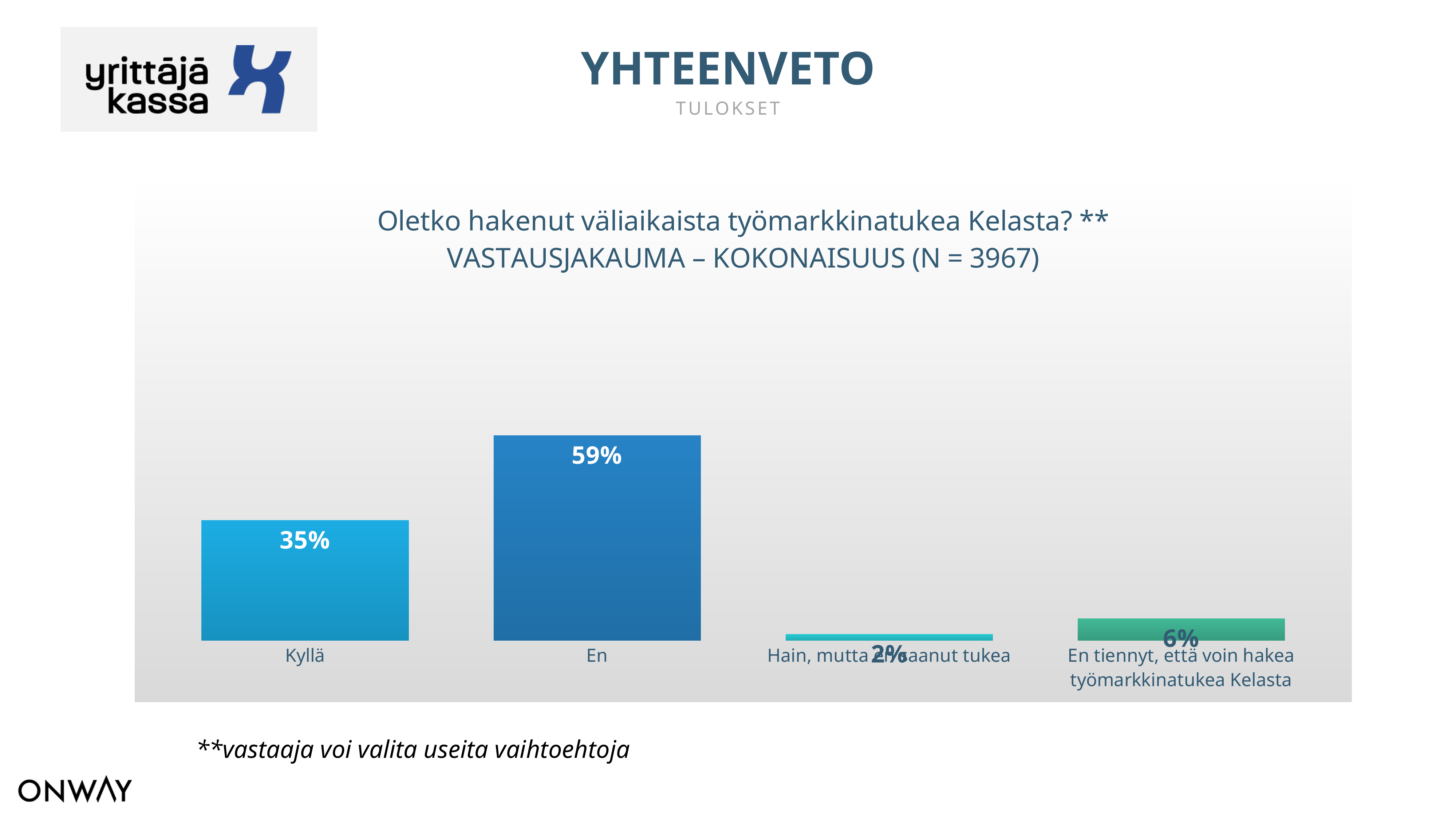
What percentage of respondents answered "En"? 59% Which category has the lowest value? Hain, mutta en saanut tukea What is the value shown for the third bar from the left ("Hain, mutta ... tukea")? 2% What is the difference between the values for "En" and "Kyllä"? 24% What kind of chart is shown on the slide? Bar chart What is the difference between the values for "En tiennyt, että voin hakea työmarkkinatukea Kelasta" and "Kyllä"? 29% What percentage of respondents answered "Kyllä"? 35% Which is larger, the value for "Kyllä" or the value for "En"? En What is the value shown for the category "En tiennyt, että voin hakea työmarkkinatukea Kelasta"? 6% Which category has the highest value? En How many categories are shown in the chart? 4 What is the sample size (N) stated in the chart title? 3967